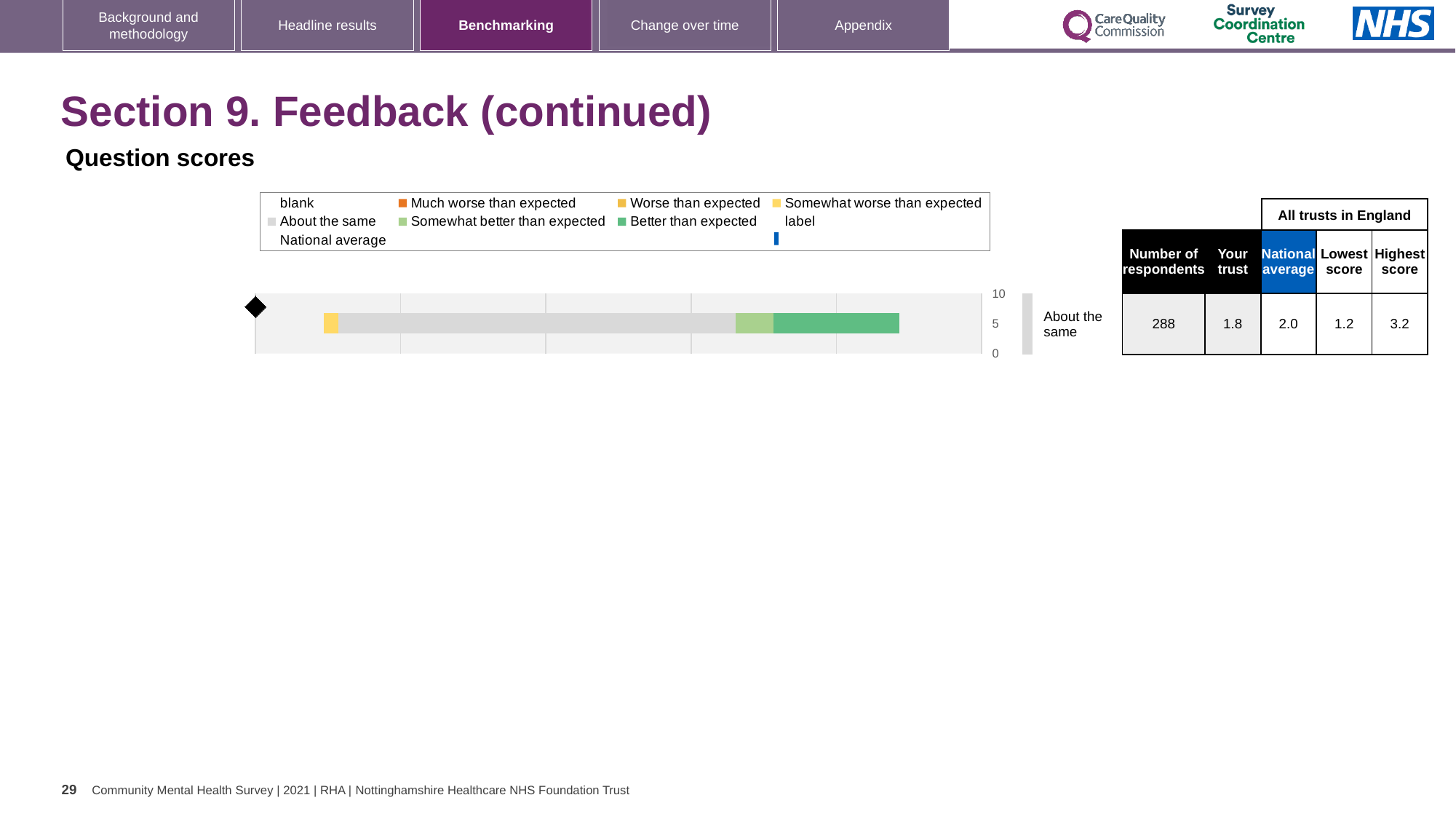
How many respondents answered the question shown? 288 What is the difference between the highest and lowest scores among all trusts in England? 2.0 What is the lowest score among all trusts in England for this question? 1.2 What is the difference between the national average and the 'Your trust' score? 0.2 How many bars are plotted in the chart? 1 What is the 'Your trust' score for the question shown? 1.8 What kind of chart is shown on the slide? bar chart What colour represents 'About the same' in the legend? grey What is the highest score among all trusts in England for this question? 3.2 What is the national average score for the question shown? 2.0 Which is larger, the 'Your trust' score or the national average? National average Which benchmarking category does the trust's score fall into for this question? About the same